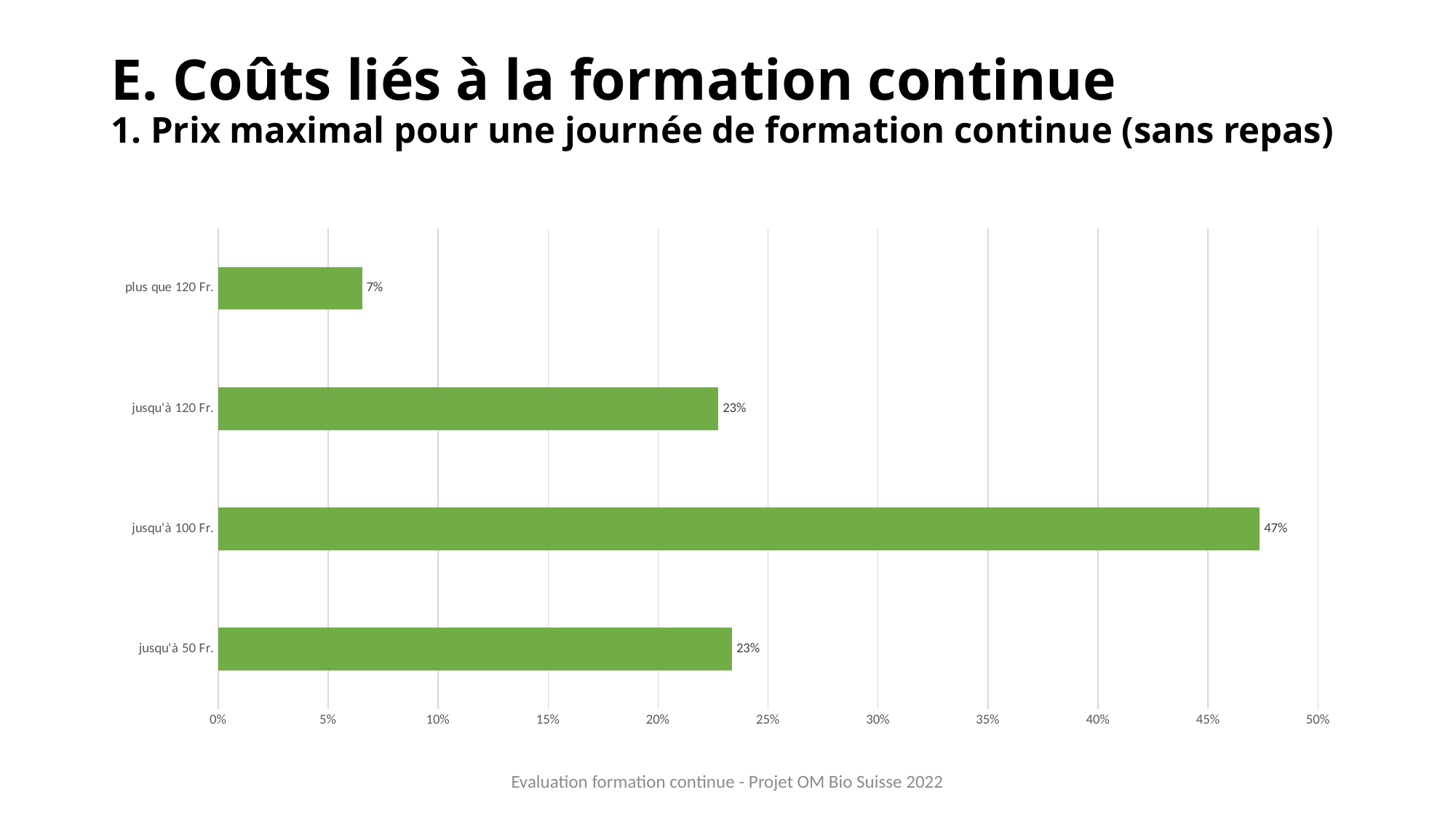
What is the difference between the values for "jusqu'à 100 Fr." and "jusqu'à 120 Fr."? 24% Which category has the lowest value? plus que 120 Fr. What is the difference between the values for "jusqu'à 50 Fr." and "plus que 120 Fr."? 16% Which is larger, the value for "jusqu'à 100 Fr." or the value for "jusqu'à 50 Fr."? jusqu'à 100 Fr. Is the value for "jusqu'à 100 Fr." greater or less than 45%? greater How many categories are shown in the chart? 4 Which category has the highest value? jusqu'à 100 Fr. What is the value for "plus que 120 Fr."? 7% What is the maximum value shown on the horizontal axis? 50% What is the value for "jusqu'à 100 Fr."? 47% What is the value for "jusqu'à 120 Fr."? 23% What kind of chart is shown on the slide? bar chart